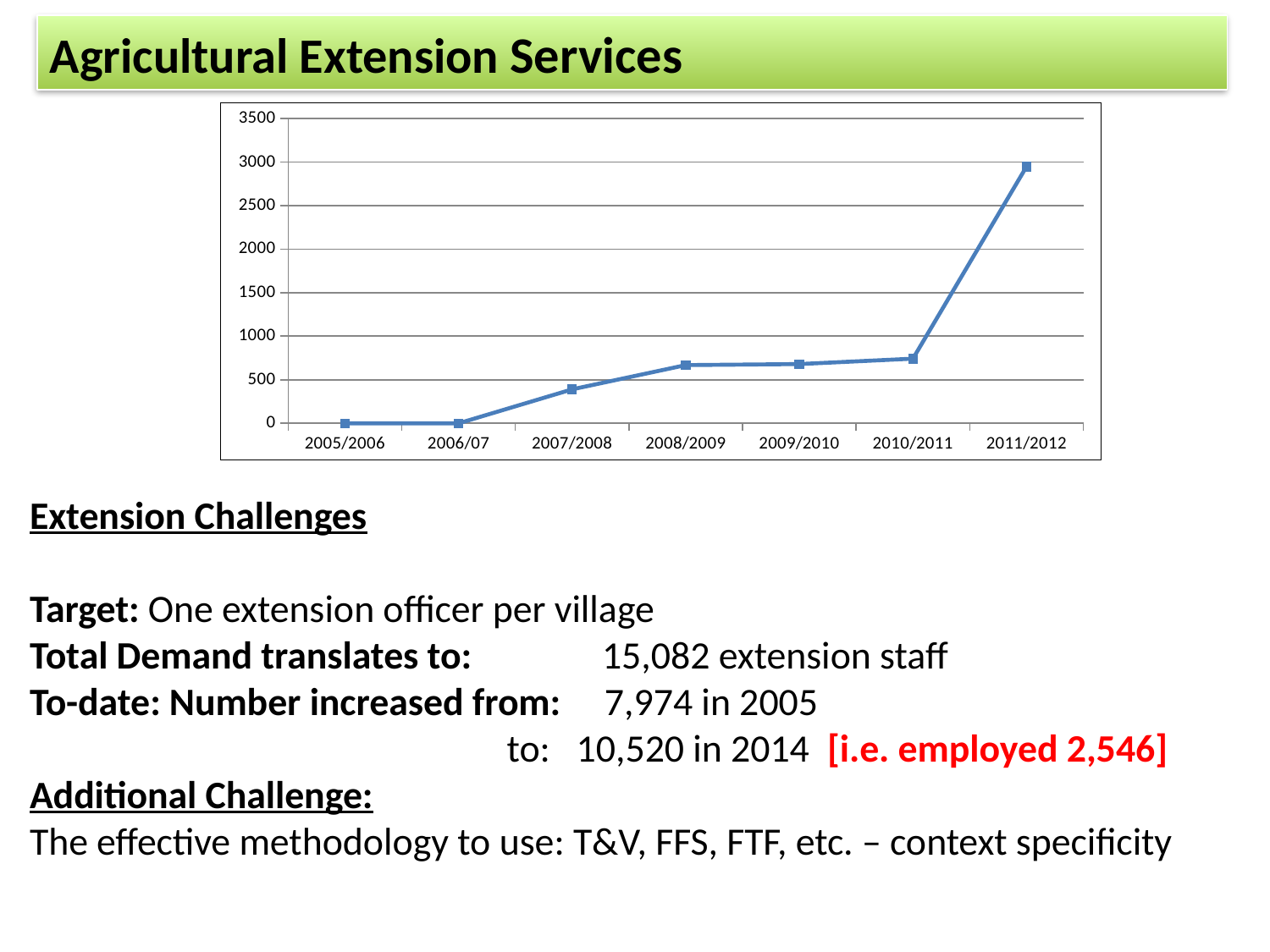
Is the value for 2010/2011 greater or less than 1000? less What is the value for 2005/2006 on the line chart? 0 Is the value for 2007/2008 greater or less than 500? less How many data points are plotted on the line chart? 7 Which year has the highest value on the line chart? 2011/2012 Which is larger, the value for 2010/2011 or the value for 2011/2012? 2011/2012 Is the value for 2008/2009 greater or less than 500? greater What is the value for 2006/07 on the line chart? 0 What is the highest tick value shown on the y axis of the chart? 3500 Do the values on the line chart generally rise or fall from 2005/2006 to 2011/2012? rise What kind of chart is shown on the slide? line chart